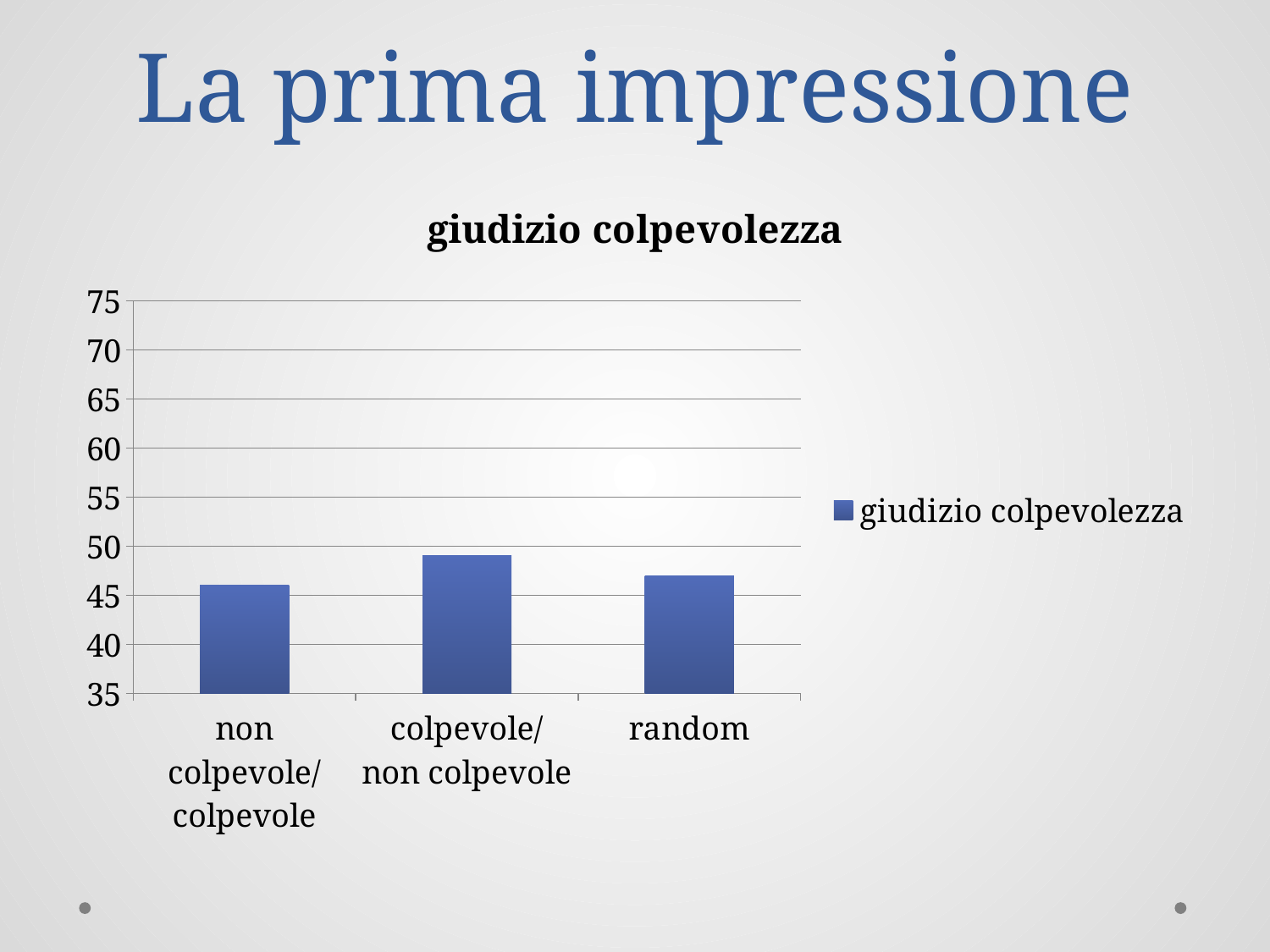
Is the value for colpevole/non colpevole greater or less than 55? less How many series does the chart legend list? 1 Is the value for random greater or less than 45? greater How many categories are shown on the x axis of the chart? 3 Which category has the highest bar in the chart? colpevole/non colpevole What kind of chart is shown on the slide? bar chart Which is larger, the value for non colpevole/colpevole or the value for colpevole/non colpevole? colpevole/non colpevole Is the value for random greater or less than 50? less Which is larger, the value for colpevole/non colpevole or the value for random? colpevole/non colpevole What is the title of the chart? giudizio colpevolezza What is the name of the series shown in the chart legend? giudizio colpevolezza